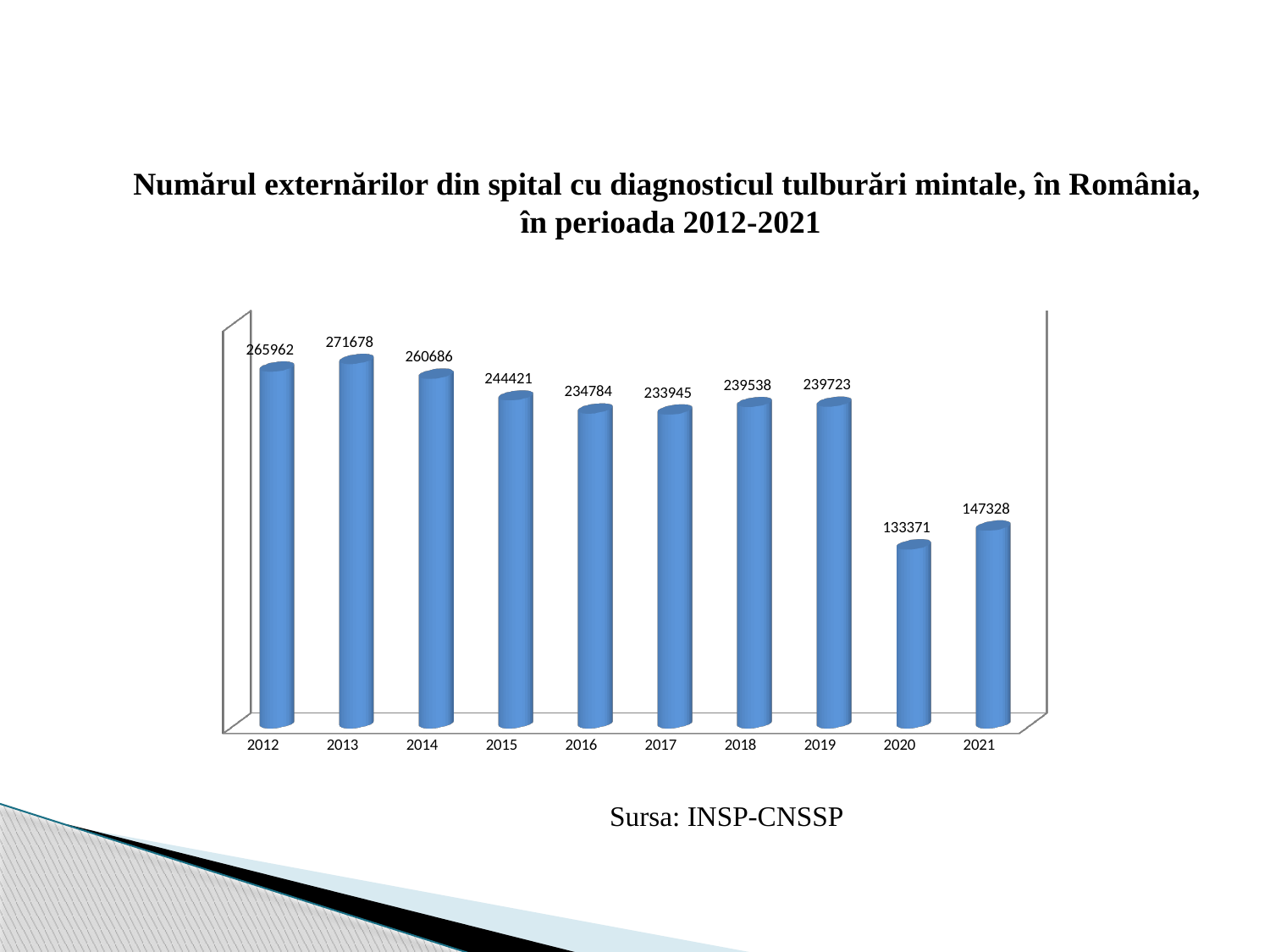
Which year has the highest number of discharges? 2013 Do the values generally rise or fall from 2012 to 2021? fall What is the difference between the values for 2013 and 2020? 138307 What is the number of hospital discharges for 2013? 271678 What is the value for 2016? 234784 What kind of chart is shown on the slide? bar chart Which is larger, the value for 2015 or the value for 2018? 2015 Which year has the lowest number of discharges? 2020 What source is cited below the chart? INSP-CNSSP How many years are shown on the x axis? 10 By how much did the value increase from 2020 to 2021? 13957 What value is shown for 2020? 133371